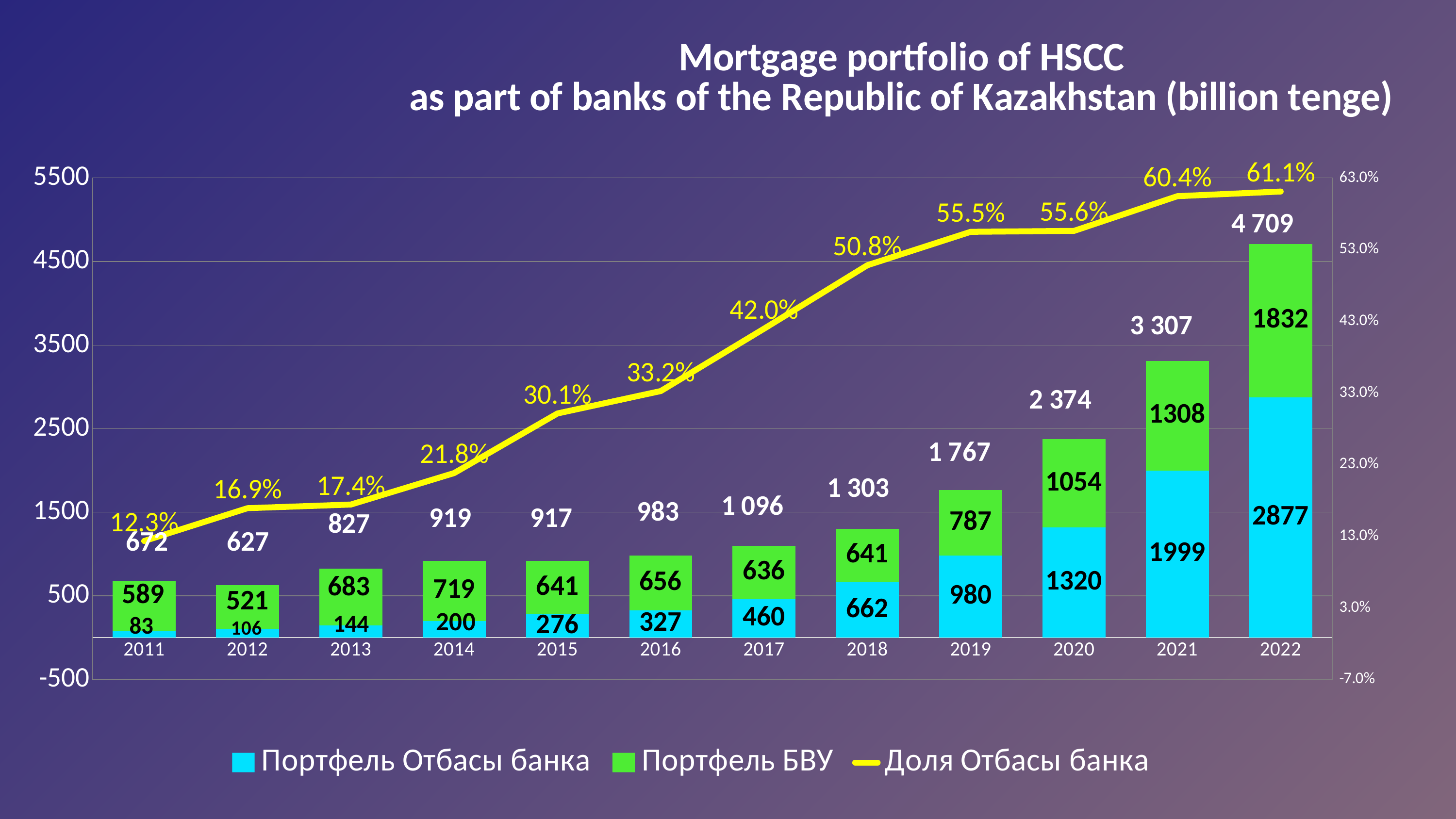
In 2019, which is larger: Портфель Отбасы банка or Портфель БВУ? Портфель Отбасы банка Does the Доля Отбасы банка line rise or fall from 2011 to 2022? Rises Which year has the lowest value for Портфель Отбасы банка? 2011 What is the Доля Отбасы банка value for 2017? 42.0% What is the difference between the Портфель Отбасы банка values for 2022 and 2021? 878 Which year has the highest total mortgage portfolio? 2022 What is the total of the stacked bar for 2022? 4 709 What is the value of Портфель Отбасы банка for 2018? 662 What is the value of Портфель БВУ for 2020? 1054 How many years are shown on the x axis? 12 What kind of chart is shown on the slide? Stacked bar chart with a line How many series does the legend list? 3